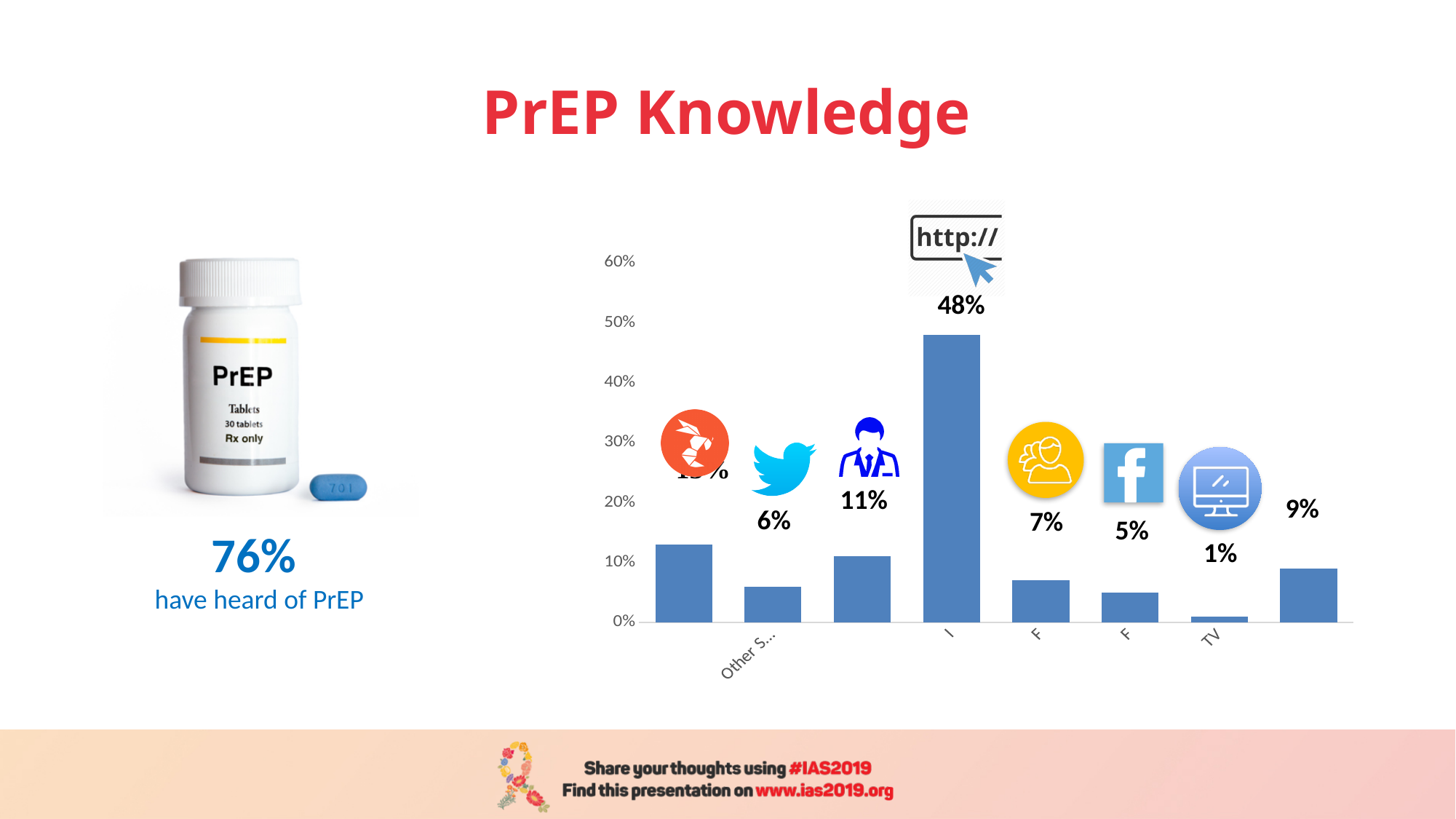
Which bar has the lowest value in the chart? the bar under the computer monitor icon (labelled TV), at 1% Which is larger: the bar under the Twitter icon or the bar under the Facebook icon? the bar under the Twitter icon What kind of chart is shown on the slide? bar chart What value is shown for the rightmost bar in the chart? 9% Which bar has the highest value in the chart? the bar under the http:// (internet) icon, at 48% What is the difference between the value of the bar under the http:// icon and the bar under the doctor icon? 37 percentage points What value is shown for the bar under the Twitter icon? 6% What is the title of the slide containing the chart? PrEP Knowledge What value is shown for the bar under the doctor icon? 11% How many bars does the chart contain? 8 What value is shown for the bar under the Facebook icon? 5%